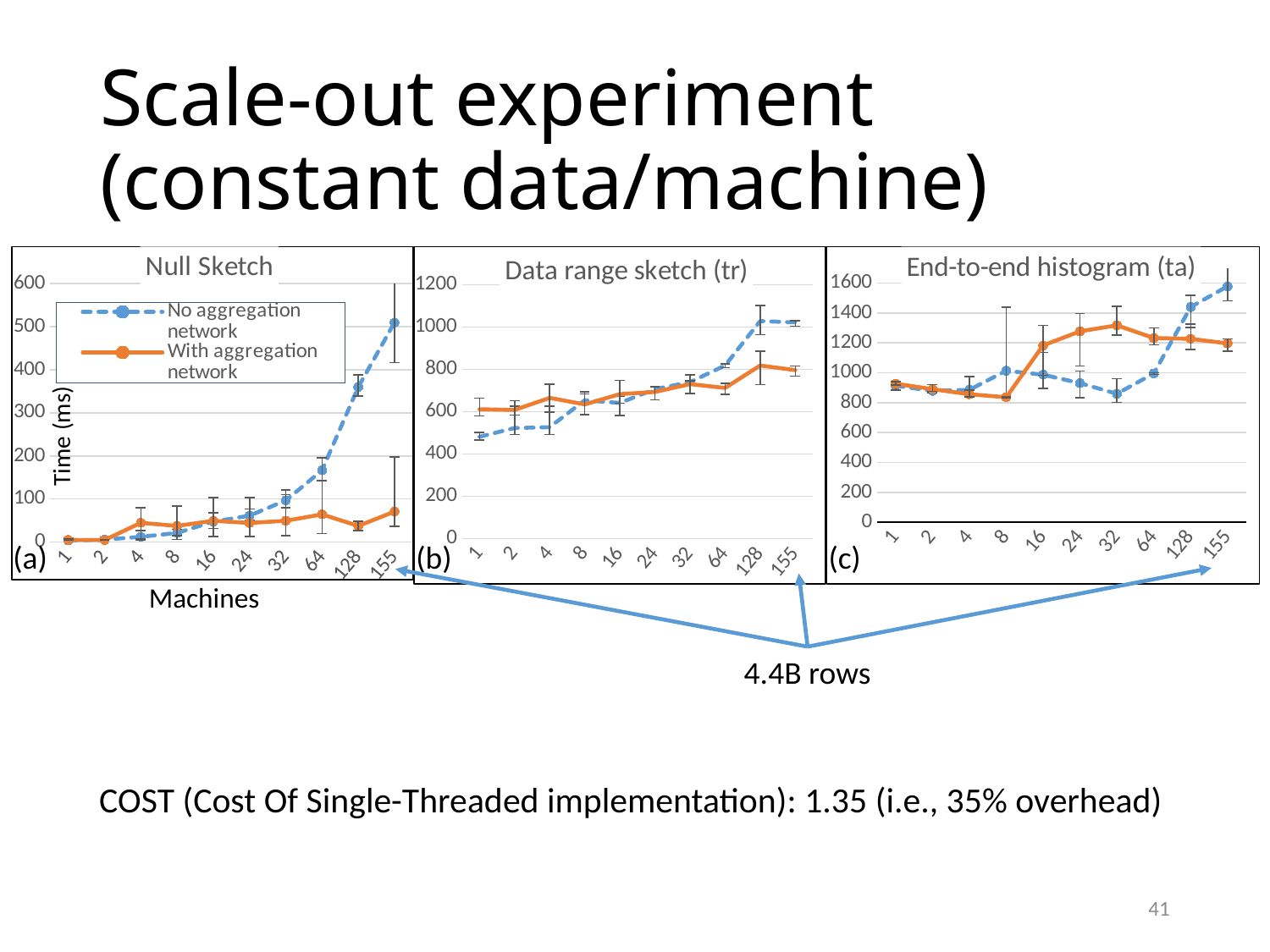
How many machine counts are plotted along the x axis of the Data range sketch (tr) chart (b)? 10 In the Null Sketch chart (a), is the No aggregation network value at 155 machines greater or less than 400? greater In the Data range sketch (tr) chart (b), which series has the higher value at 1 machine? With aggregation network In the Null Sketch chart (a), is the With aggregation network value at 155 machines greater or less than 200? less What kind of chart is the Null Sketch chart (a)? line chart How many series does the legend in the Null Sketch chart (a) list? 2 In the End-to-end histogram (ta) chart (c), is the No aggregation network value at 155 machines greater or less than 1400? greater In the Null Sketch chart (a), at which machine count does the No aggregation network series reach its highest value? 155 What is the y-axis label of the Null Sketch chart (a)? Time (ms) In the Null Sketch chart (a), which series has the higher value at 155 machines? No aggregation network In the Data range sketch (tr) chart (b), does the No aggregation network series generally rise or fall as the number of machines increases? rise